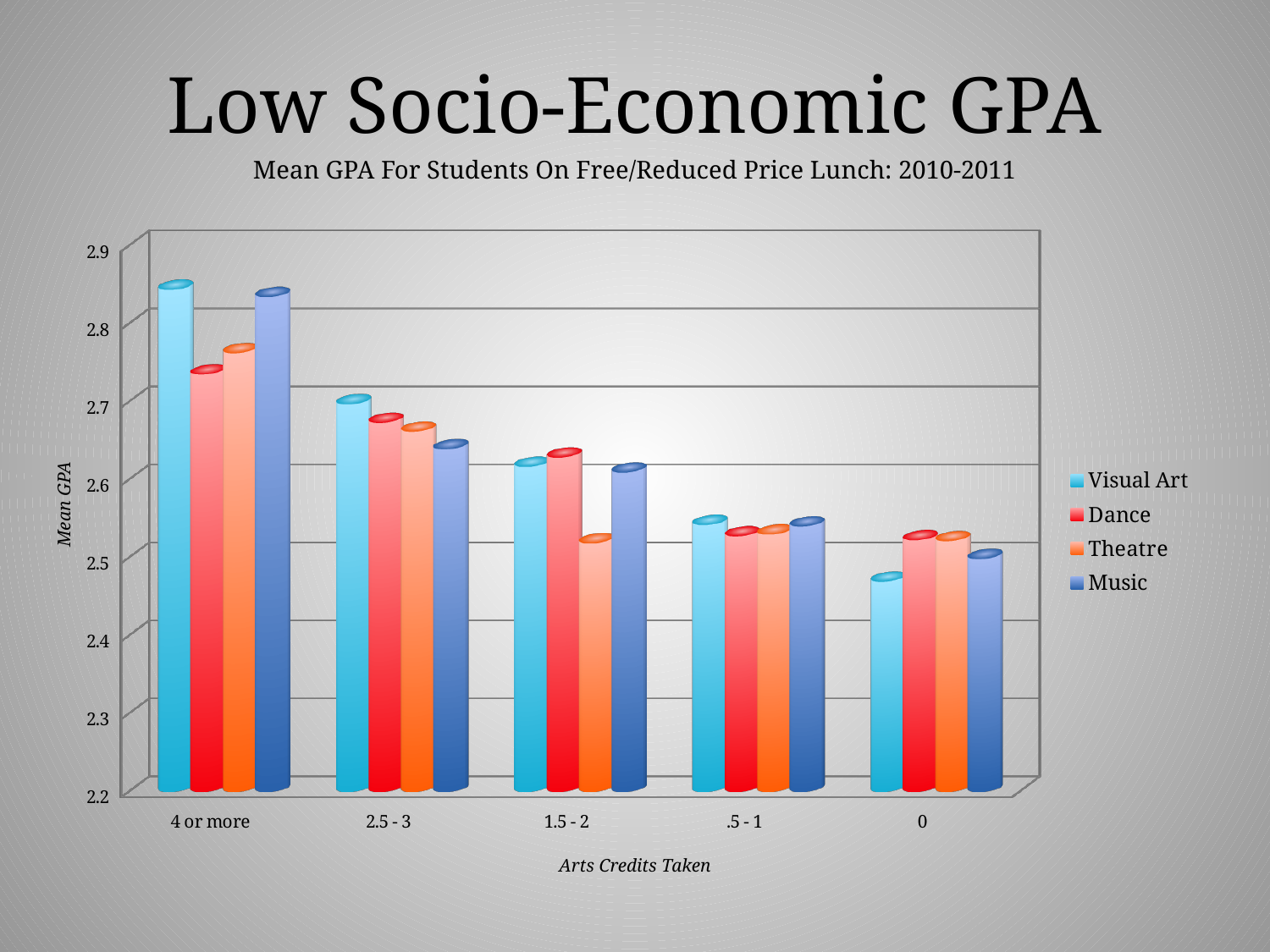
Is the Visual Art value for the '0' category greater or less than 2.5? less Which Arts Credits Taken category has the highest Visual Art mean GPA? 4 or more Is the Visual Art value for the '4 or more' category greater or less than 2.8? greater What kind of chart is shown on the slide? bar chart How many Arts Credits Taken categories are shown on the x axis? 5 How many series does the legend list? 4 Is the Dance value for the '4 or more' category greater or less than 2.7? greater Does the Visual Art mean GPA rise or fall moving along the x axis from '4 or more' to '0'? fall In the '1.5 - 2' category, which is larger: Theatre or Music? Music What is the title of the x axis? Arts Credits Taken In the '4 or more' category, which is larger: Visual Art or Dance? Visual Art